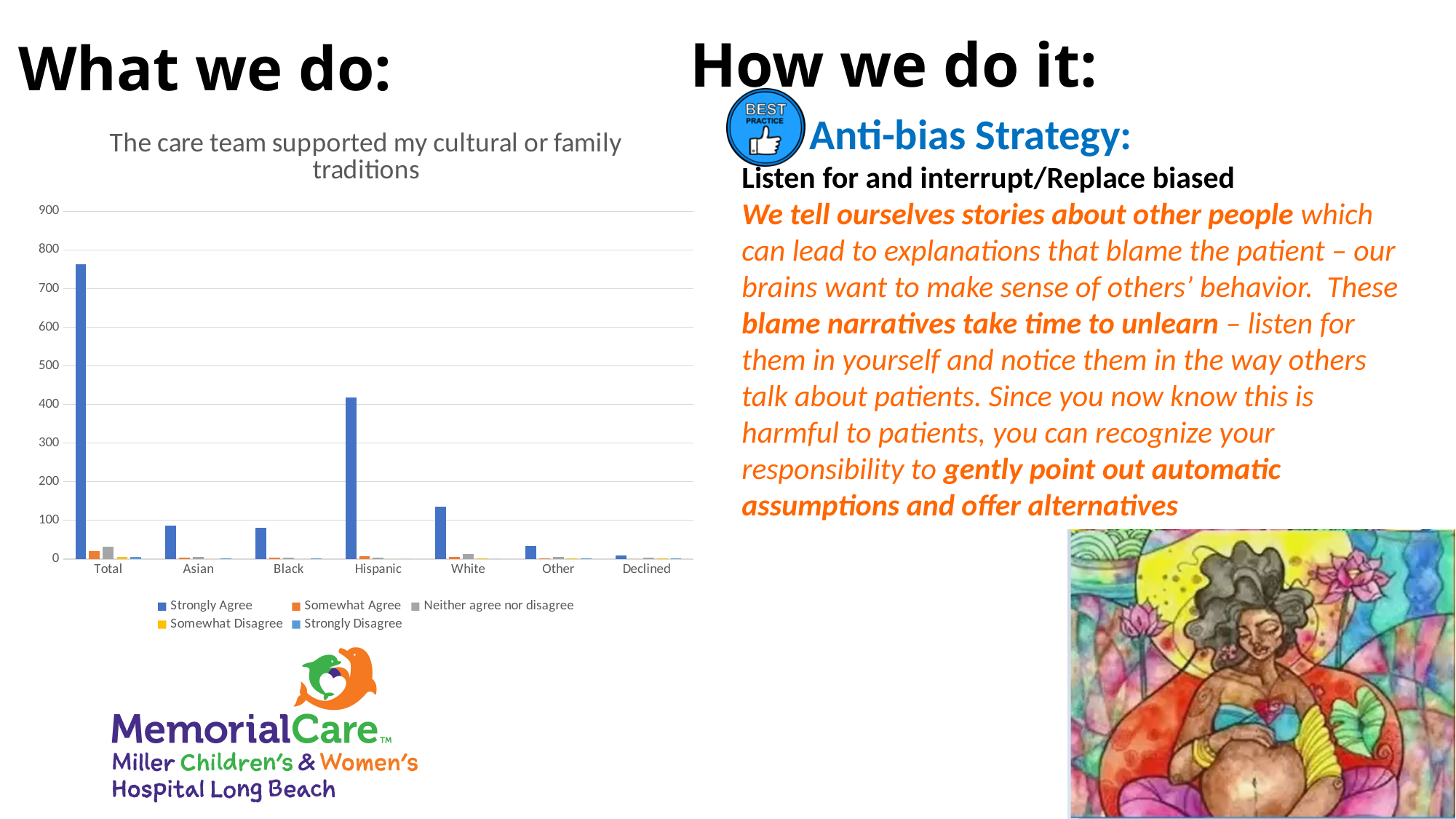
Is the Strongly Agree value for White greater or less than 100? greater Is the Strongly Agree value for Total greater or less than 700? greater How many series does the chart's legend list? 5 What kind of chart is shown on the slide? bar chart Is the Strongly Agree value for Other greater or less than 100? less Which category has the lowest Strongly Agree value? Declined How many categories are shown on the x axis of the chart? 7 What is the title of the chart? The care team supported my cultural or family traditions Which has the larger Strongly Agree value, Hispanic or White? Hispanic Excluding Total, which category has the highest Strongly Agree value? Hispanic